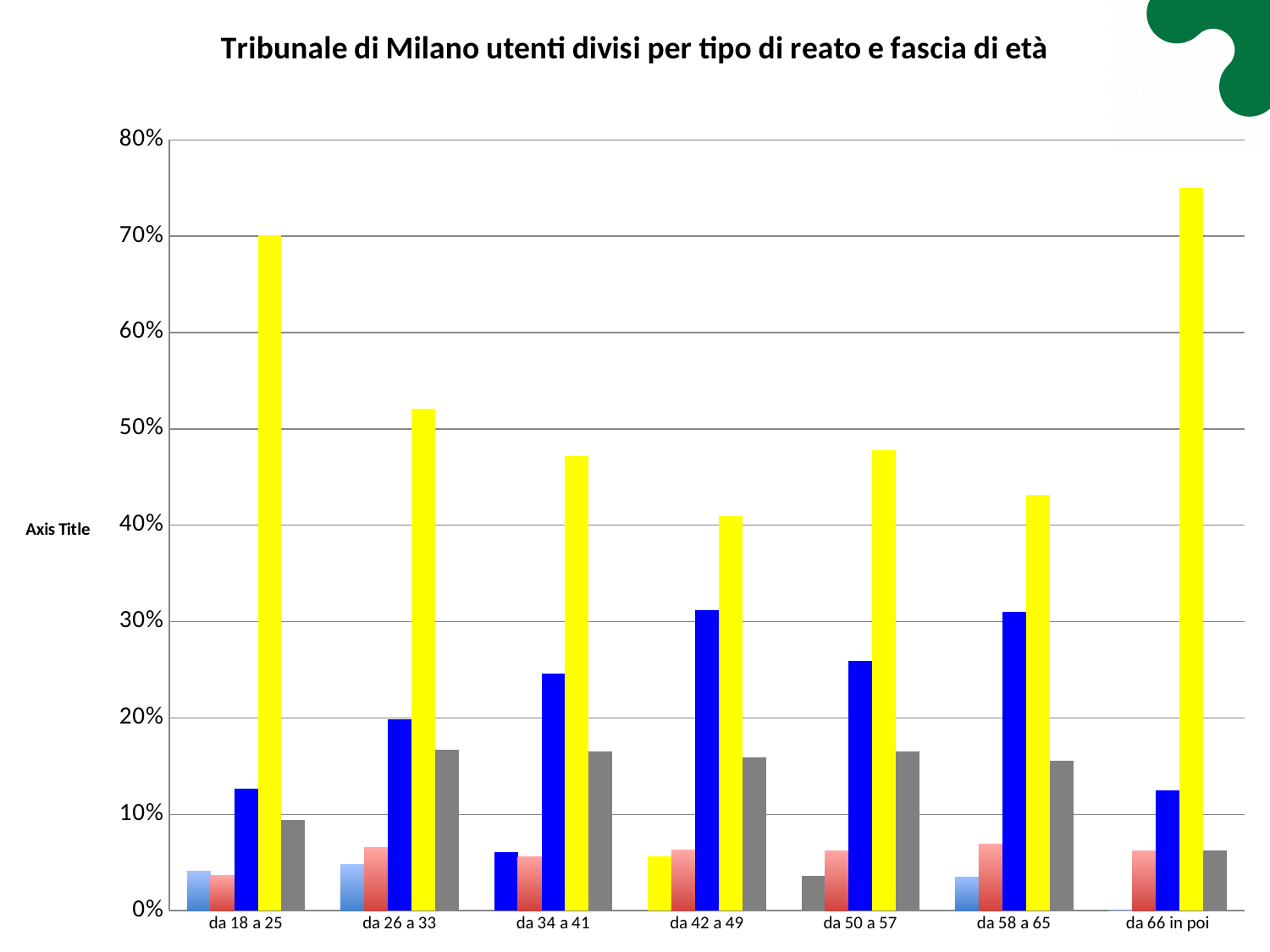
Is the blue bar for 'da 18 a 25' greater or less than 20%? less Is the yellow bar for 'da 26 a 33' greater or less than 50%? greater What text is shown as the vertical axis title? Axis Title How many age-group categories are shown on the x axis? 7 Is the yellow bar for 'da 66 in poi' greater or less than 70%? greater Which has the taller blue bar, 'da 42 a 49' or 'da 26 a 33'? da 42 a 49 What is the title of the chart? Tribunale di Milano utenti divisi per tipo di reato e fascia di età Which age group has the tallest yellow bar? da 66 in poi What kind of chart is shown on the slide? bar chart Which has the taller yellow bar, 'da 18 a 25' or 'da 34 a 41'? da 18 a 25